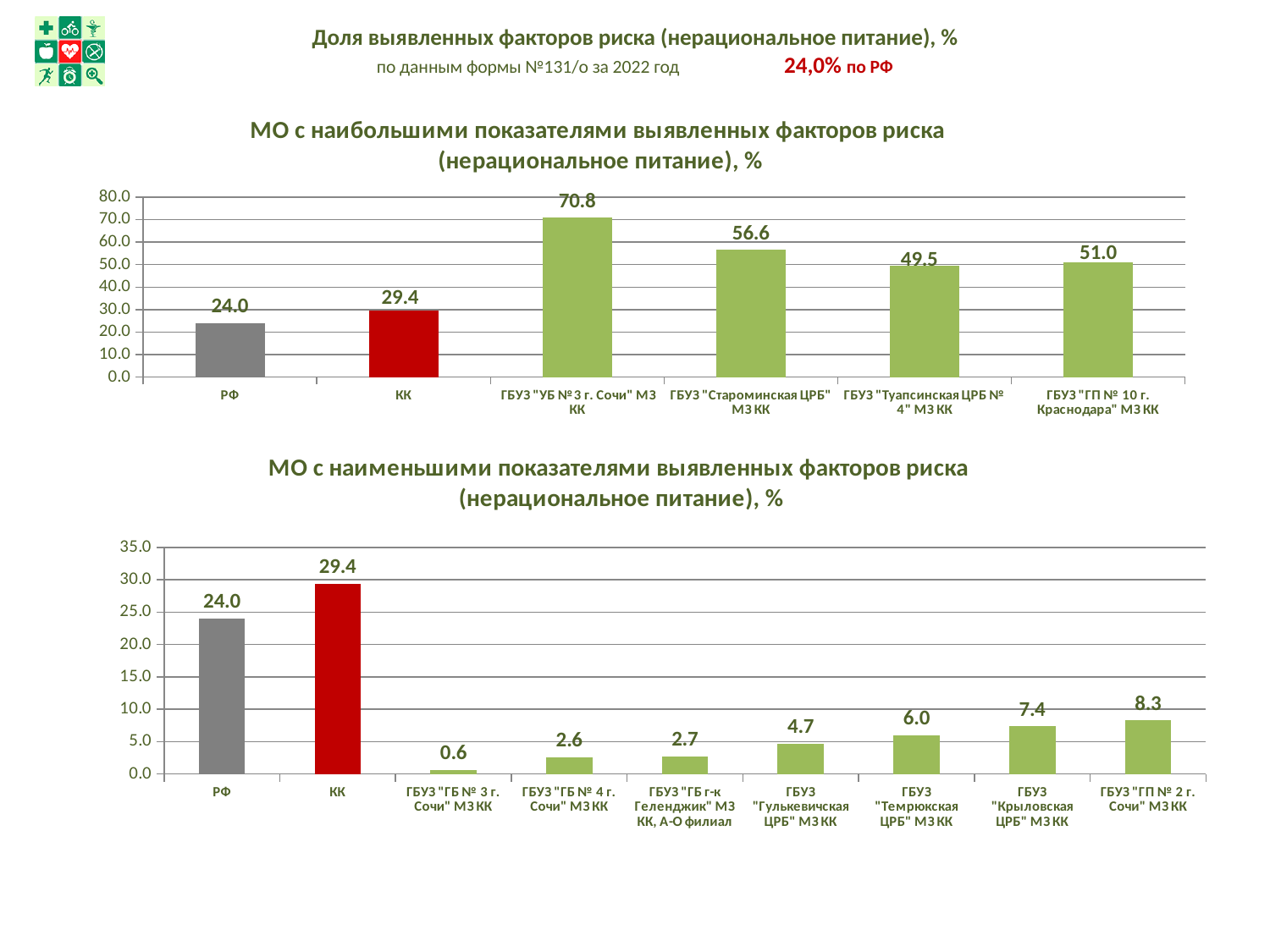
In the top chart (МО с наибольшими показателями), how many bars are plotted? 6 In the bottom chart (МО с наименьшими показателями), is the value for ГБУЗ "ГП № 2 г. Сочи" МЗ КК greater or less than 10.0? less In the top chart (МО с наибольшими показателями), what is the difference between ГБУЗ "Староминская ЦРБ" МЗ КК and КК? 27.2 In the bottom chart (МО с наименьшими показателями), what colour is the bar for КК? Red In the top chart (МО с наибольшими показателями), which category has the highest value? ГБУЗ "УБ №3 г. Сочи" МЗ КК What type of chart is the top chart (МО с наибольшими показателями)? Bar chart In the bottom chart (МО с наименьшими показателями), how many bars are plotted? 9 In the top chart (МО с наибольшими показателями), which is larger: ГБУЗ "Туапсинская ЦРБ № 4" МЗ КК or ГБУЗ "ГП № 10 г. Краснодара" МЗ КК? ГБУЗ "ГП № 10 г. Краснодара" МЗ КК In the bottom chart (МО с наименьшими показателями), what is the value for ГБУЗ "Темрюкская ЦРБ" МЗ КК? 6.0 In the top chart (МО с наибольшими показателями), what is the value for ГБУЗ "УБ №3 г. Сочи" МЗ КК? 70.8 In the bottom chart (МО с наименьшими показателями), which category has the lowest value? ГБУЗ "ГБ № 3 г. Сочи" МЗ КК In the bottom chart (МО с наименьшими показателями), what is the difference between КК and РФ? 5.4